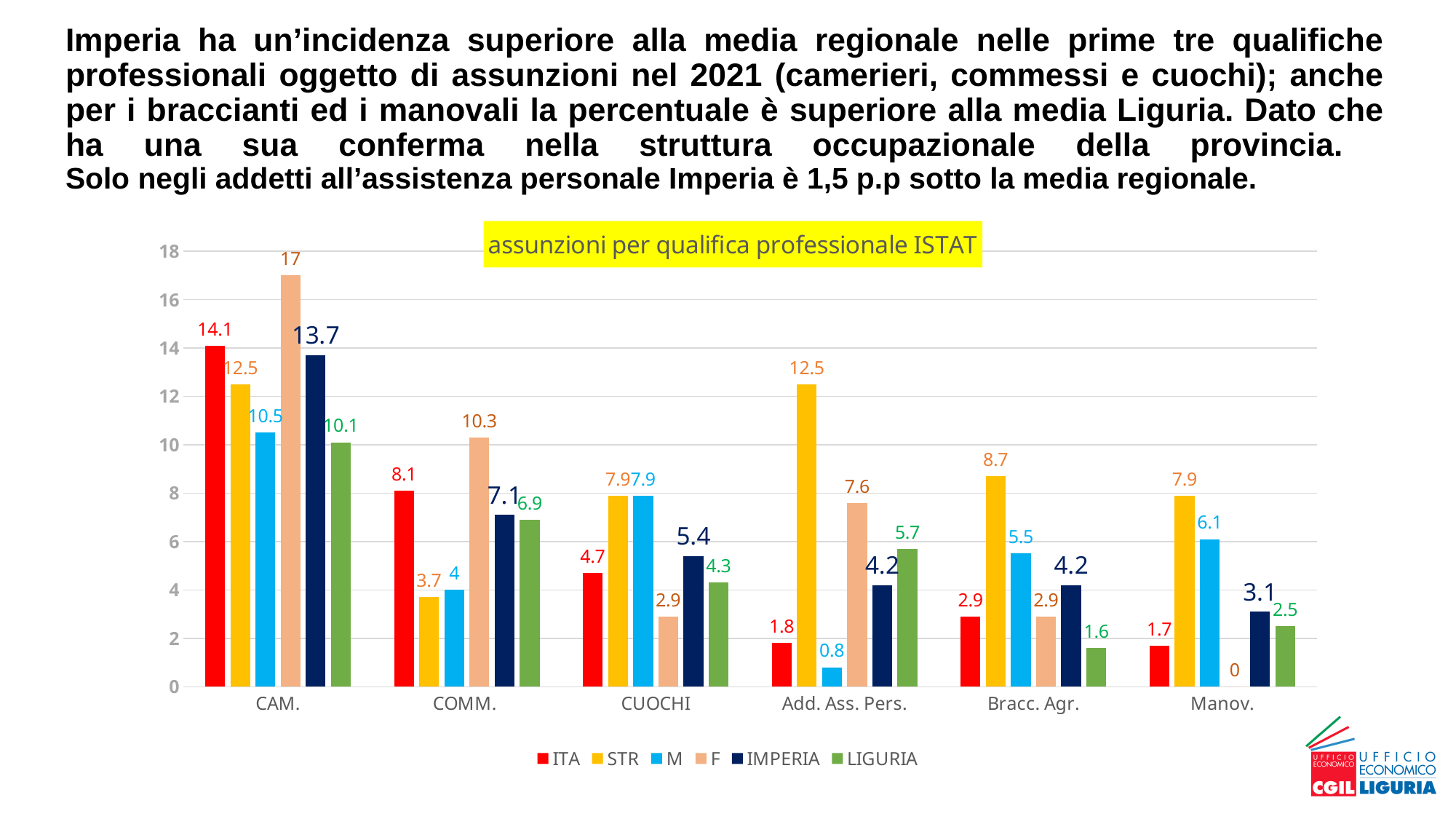
What is the difference between the IMPERIA and LIGURIA values for Add. Ass. Pers.? 1.5 How many series does the legend list? 6 Which category has the lowest LIGURIA value? Bracc. Agr. What is the F value for Add. Ass. Pers.? 7.6 What is the IMPERIA value for CAM.? 13.7 How many categories are shown on the x axis? 6 What is the M value for Manov.? 6.1 Which category has the highest IMPERIA value? CAM. What kind of chart is shown on the slide? Bar chart Which is larger for COMM., the IMPERIA value or the LIGURIA value? IMPERIA What is the STR value for Bracc. Agr.? 8.7 What is the title of the chart? assunzioni per qualifica professionale ISTAT